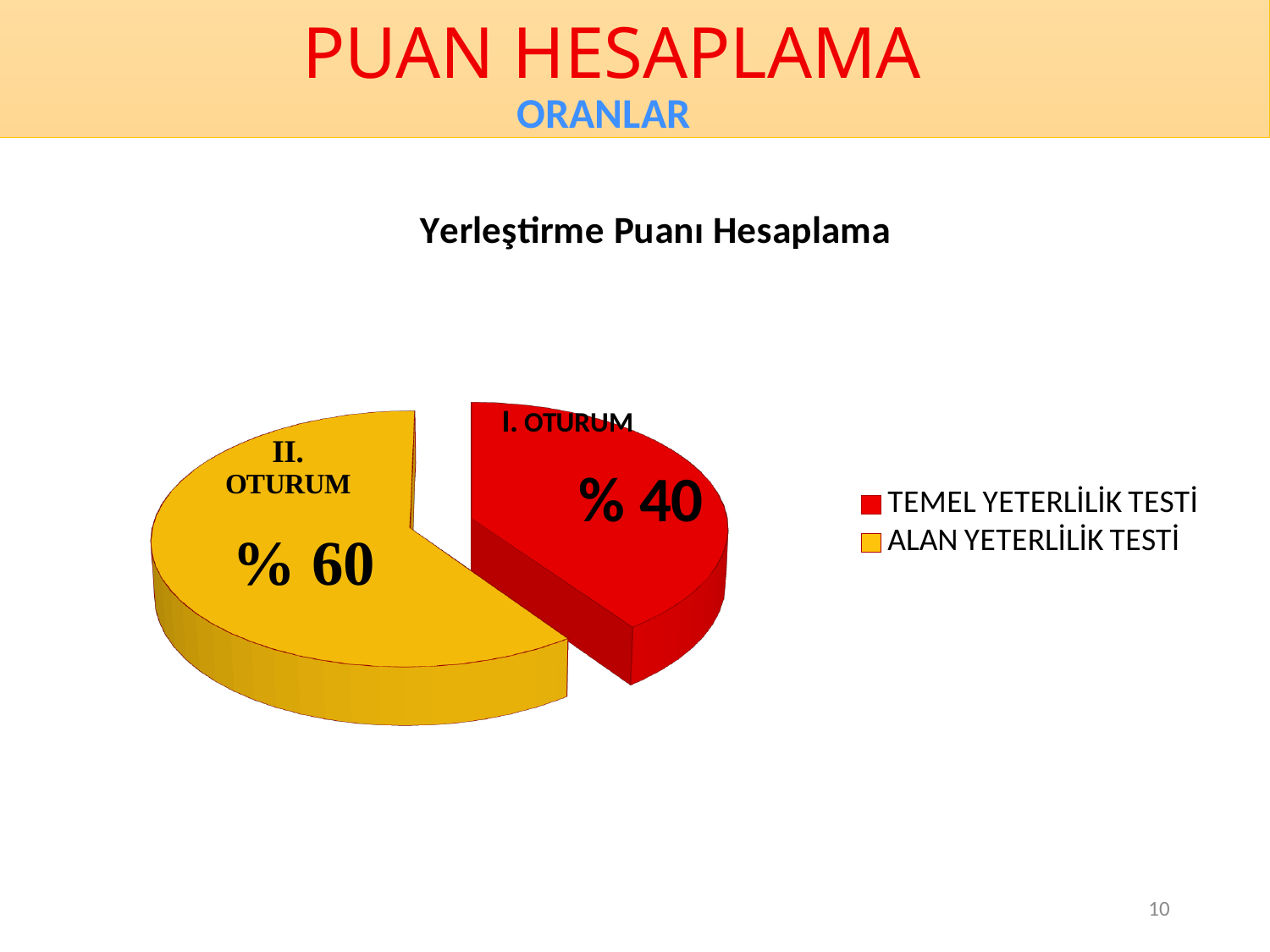
Which slice is the largest? II. OTURUM What is the difference between the II. OTURUM and I. OTURUM percentages? 20 Which slice is the smallest? I. OTURUM Which legend entry is shown in red? TEMEL YETERLİLİK TESTİ What percentage is shown for the II. OTURUM slice? % 60 Which is larger, the I. OTURUM slice or the II. OTURUM slice? II. OTURUM What is the chart's title? Yerleştirme Puanı Hesaplama How many slices does the pie chart have? 2 What percentage is shown for the I. OTURUM slice? % 40 What share of the pie does the I. OTURUM slice represent? % 40 How many entries does the legend list? 2 What kind of chart is shown on the slide? pie chart